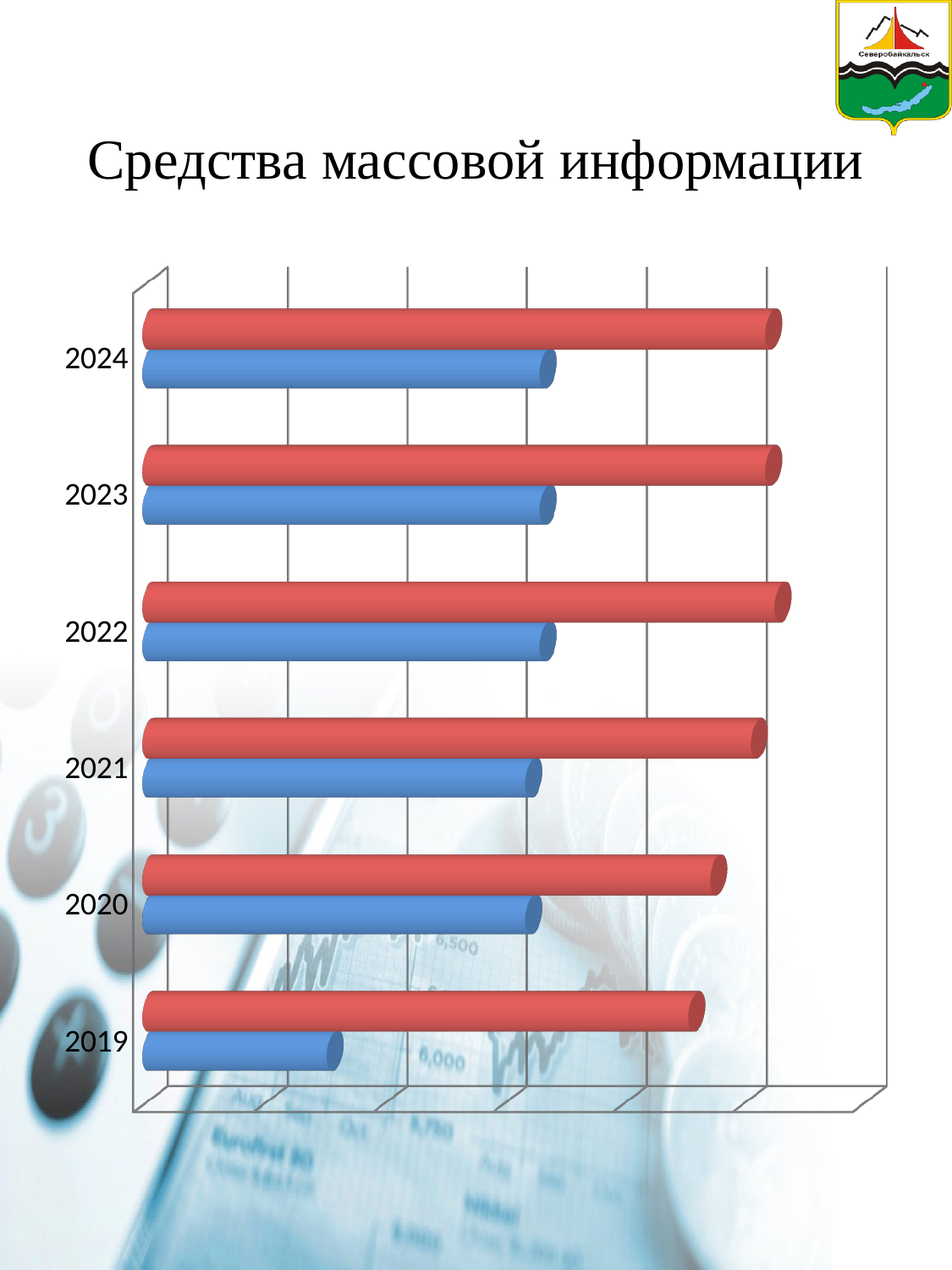
Which year has the shortest blue bar on the chart? 2019 How many bars are plotted for each year on the chart? 2 Which year is listed at the top of the chart? 2024 How many years (categories) are shown on the chart? 6 Does the blue bar rise or fall from 2019 to 2020? rise Which is longer, the blue bar for 2019 or the blue bar for 2020? 2020 What kind of chart is shown on the slide? bar chart For 2019, which bar is longer, the red one or the blue one? red Which is longer, the red bar for 2020 or the red bar for 2021? 2021 What are the two colours of the bars on the chart? red and blue What is the title of the chart on the slide? Средства массовой информации